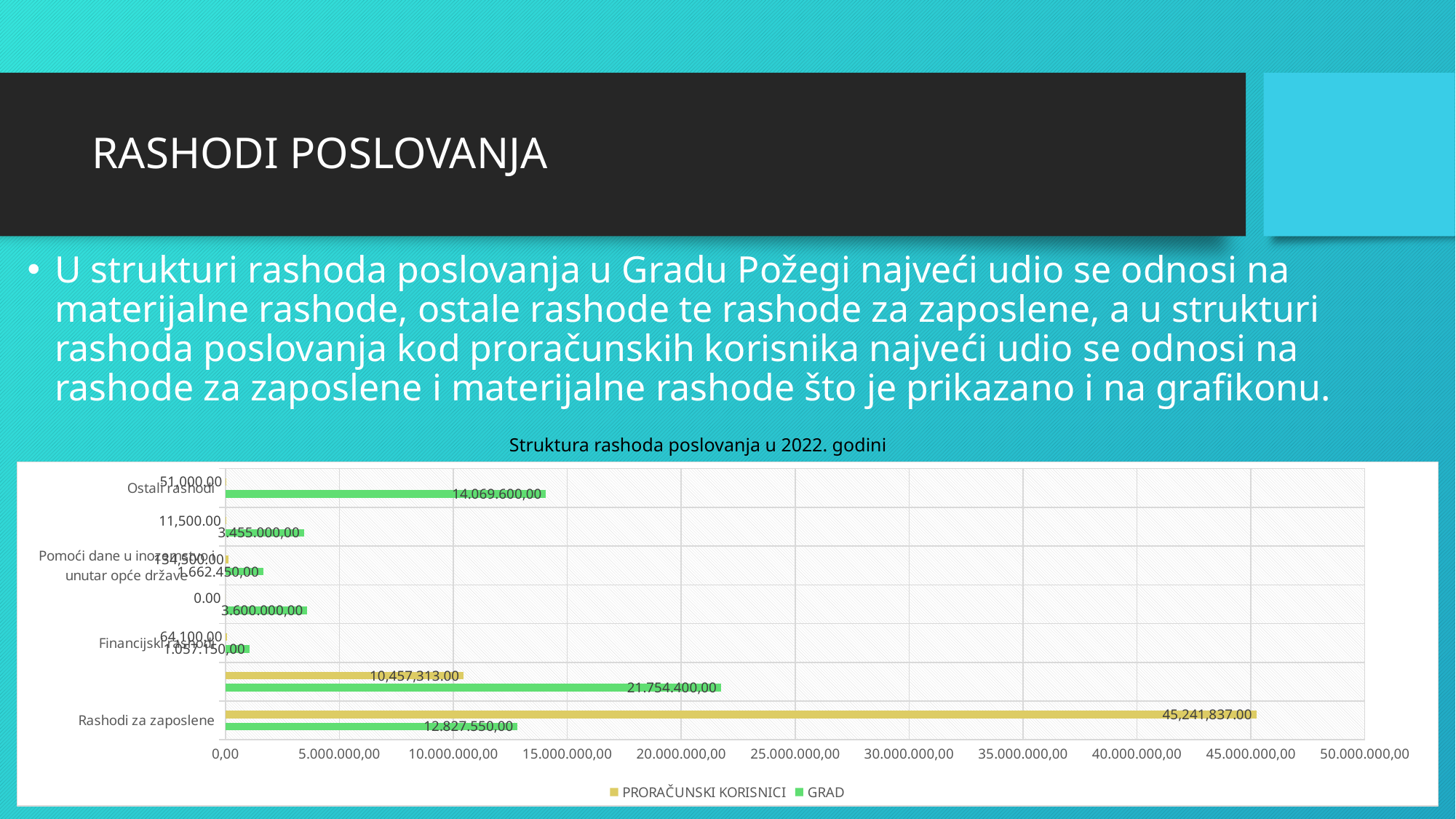
In the Rashodi za zaposlene category, which series has the larger value, PRORAČUNSKI KORISNICI or GRAD? PRORAČUNSKI KORISNICI What is the value for GRAD in the Rashodi za zaposlene category? 12.827.550,00 What is the value for GRAD in the Ostali rashodi category? 14.069.600,00 What kind of chart is shown on the slide? Bar chart What is the title of the chart? Struktura rashoda poslovanja u 2022. godini What is the value for PRORAČUNSKI KORISNICI in the Financijski rashodi category? 64,100.00 What is the difference between the PRORAČUNSKI KORISNICI value and the GRAD value in the Rashodi za zaposlene category? 32,414,287.00 What is the value for PRORAČUNSKI KORISNICI in the Rashodi za zaposlene category? 45,241,837.00 What is the value for GRAD in the Financijski rashodi category? 1.057.150,00 Which category has the highest value for the PRORAČUNSKI KORISNICI series? Rashodi za zaposlene How many series does the legend list? 2 In the Ostali rashodi category, which series has the larger value, PRORAČUNSKI KORISNICI or GRAD? GRAD